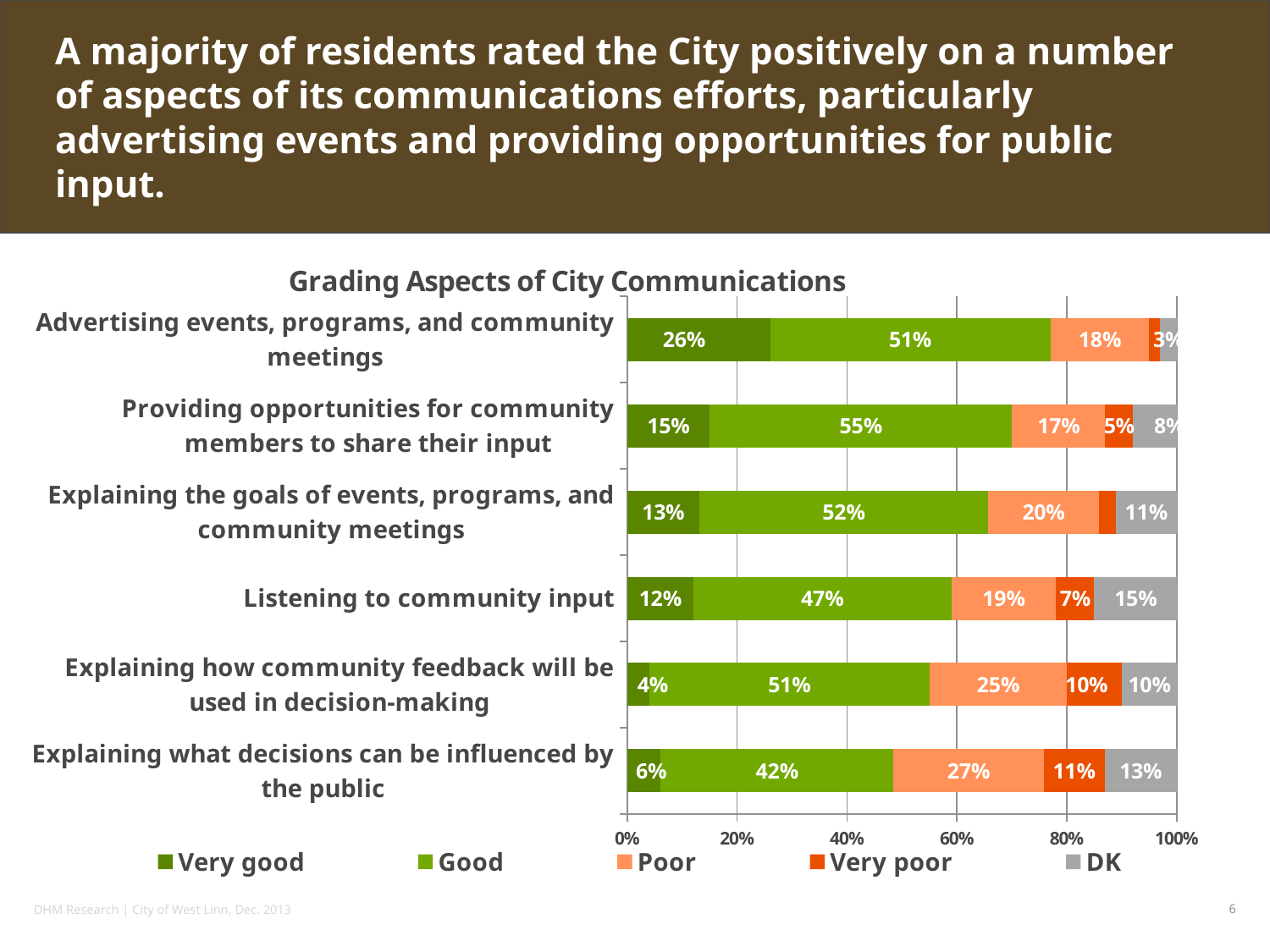
What is the title of the chart? Grading Aspects of City Communications What is the DK value for 'Listening to community input'? 15% What is the total of all segments in the bar for 'Listening to community input'? 100% Which aspect has the highest Very good rating? Advertising events, programs, and community meetings Which aspect has the lowest Very good rating? Explaining how community feedback will be used in decision-making What percentage rated 'Providing opportunities for community members to share their input' as Good? 55% What type of chart is shown on the slide? Stacked bar chart What percentage rated 'Explaining what decisions can be influenced by the public' as Poor? 27% How many aspects of city communications are shown in the chart? 6 Which has a larger Poor rating: 'Listening to community input' or 'Explaining how community feedback will be used in decision-making'? Explaining how community feedback will be used in decision-making What is the difference between the Good rating for 'Providing opportunities for community members to share their input' and the Good rating for 'Explaining what decisions can be influenced by the public'? 13% How many series does the legend list? 5